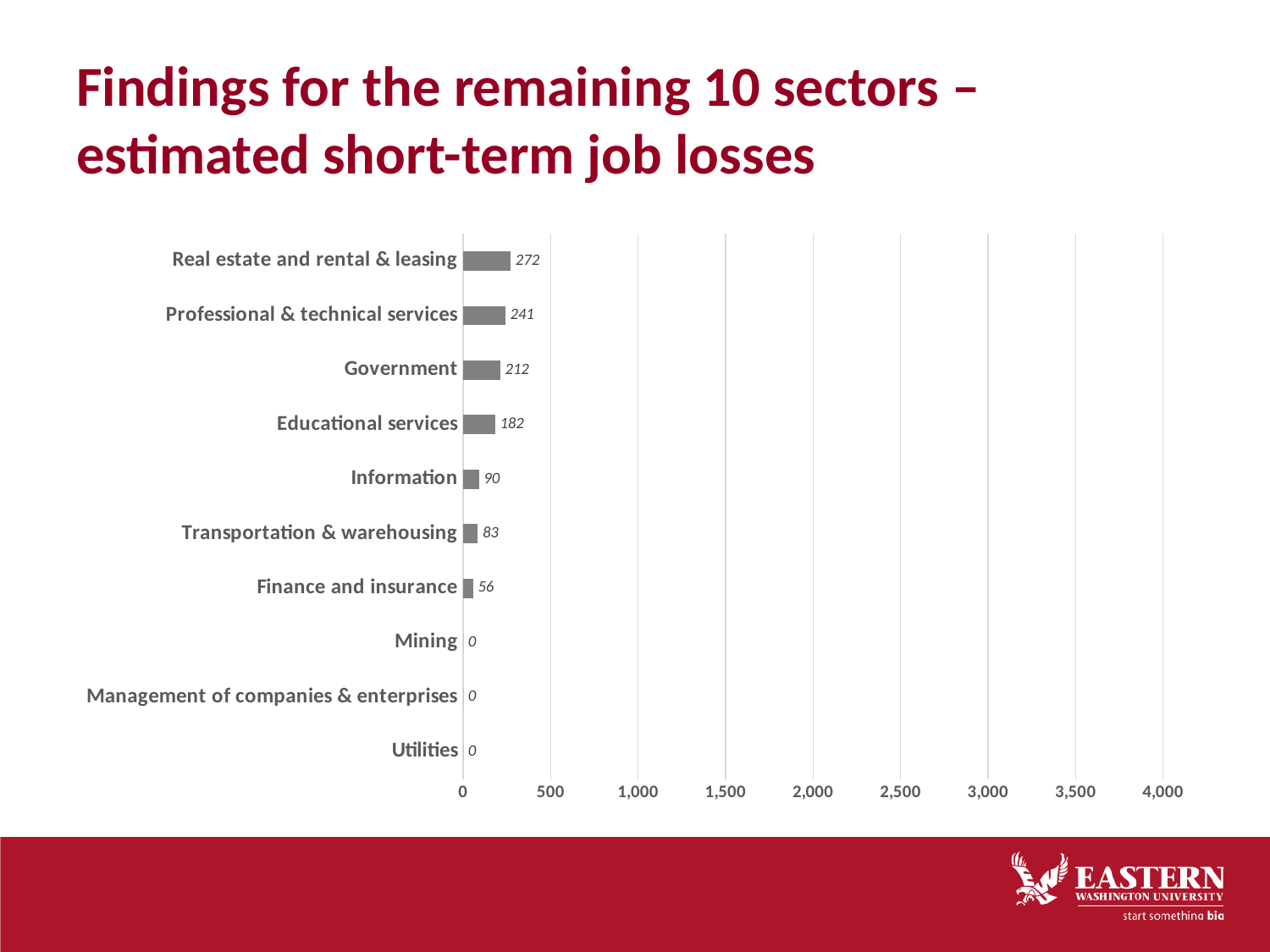
Which sector has the highest estimated short-term job losses? Real estate and rental & leasing Is the value for Real estate and rental & leasing greater or less than 500? less What is the difference in estimated job losses between Educational services and Information? 92 Which has higher estimated job losses, Government or Educational services? Government What is the highest value shown on the x axis? 4,000 What is the difference in estimated job losses between Real estate and rental & leasing and Professional & technical services? 31 What is the estimated short-term job loss for Finance and insurance? 56 What is the estimated short-term job loss for Transportation & warehousing? 83 What kind of chart is shown on the slide? Bar chart How many sectors are shown in the chart? 10 What is the estimated short-term job loss for Government? 212 How many sectors show a value of 0? 3